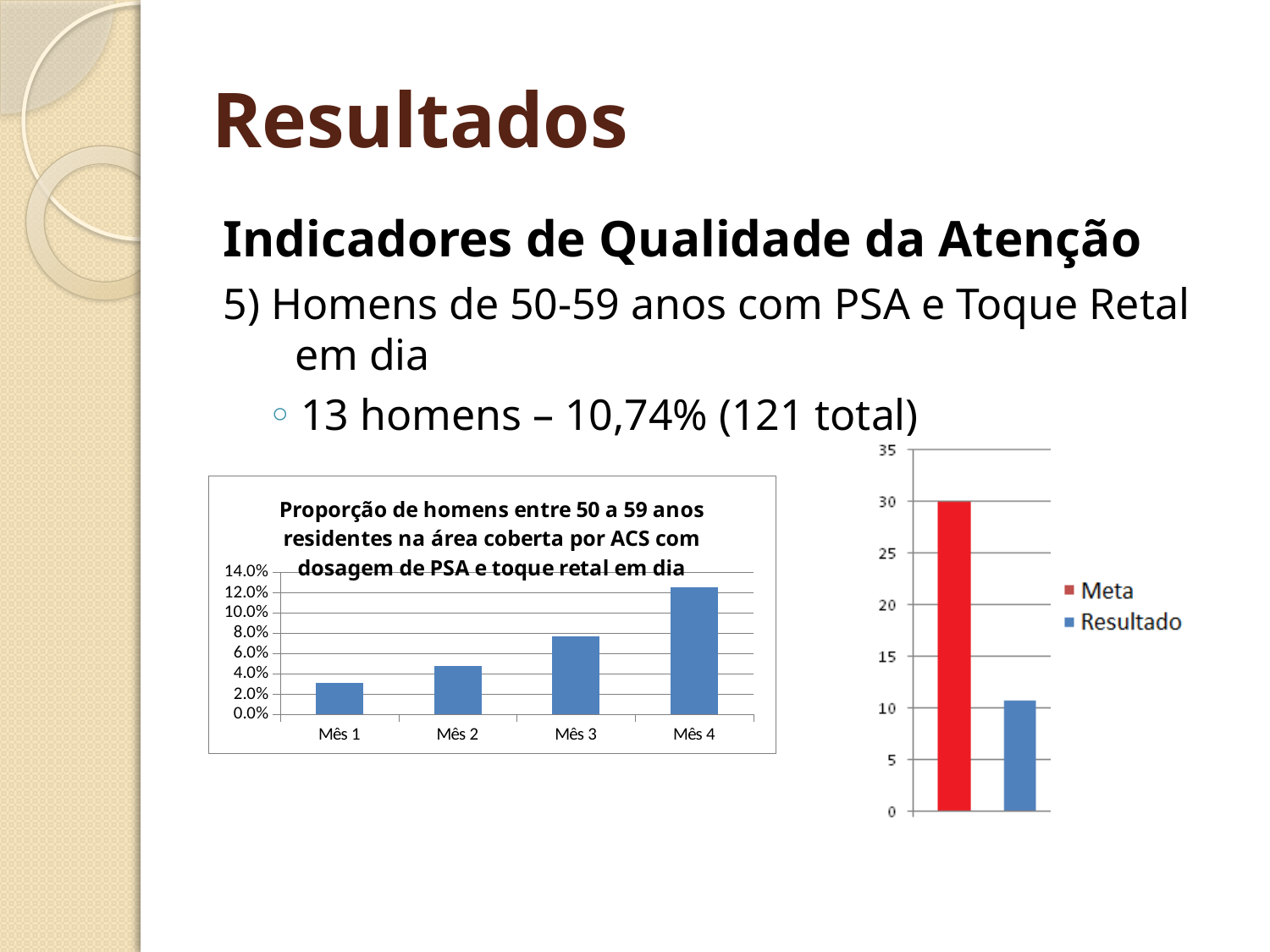
In the left chart, which month has the highest value? Mês 4 In the right chart, is the value for Resultado greater or less than 15? less In the left chart, how many months (categories) are shown on the x axis? 4 In the left chart, which is larger, the value for Mês 2 or the value for Mês 3? Mês 3 In the left chart, is the value for Mês 4 greater or less than 12.0%? greater In the right chart, how many series does the legend list? 2 In the left chart, do the values rise or fall from Mês 1 to Mês 4? rise What kind of chart is the left chart titled 'Proporção de homens entre 50 a 59 anos...'? bar chart In the left chart, is the value for Mês 1 greater or less than 4.0%? less In the right chart, which series has the higher value, Meta or Resultado? Meta In the right chart, what colour is the Meta bar? red In the left chart, which month has the lowest value? Mês 1